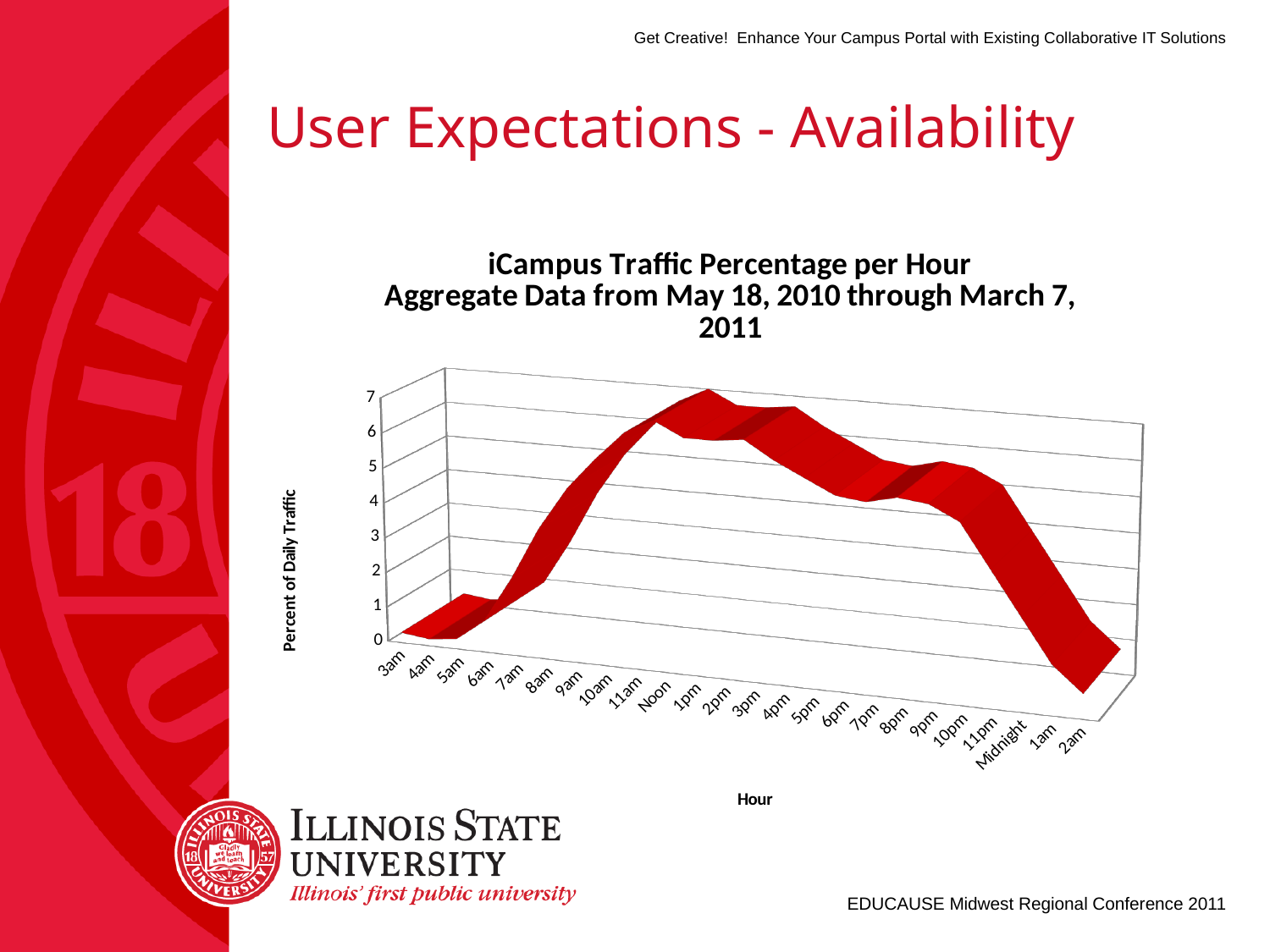
Do the values rise or fall from 3am to 1pm? rise Which has the larger value, 1pm or 7am? 1pm Is the value for 9am greater or less than 2? greater At which hour does the traffic percentage reach its highest value? Noon Is the value for 2am greater or less than 1? less Do the values rise or fall from 9pm to 2am? fall What kind of chart is shown on the slide? 3D line chart What is the title of the chart? iCampus Traffic Percentage per Hour Aggregate Data from May 18, 2010 through March 7, 2011 How many hour categories are plotted along the x axis? 24 What is the label of the vertical axis? Percent of Daily Traffic Is the value for 1pm greater or less than 5? greater